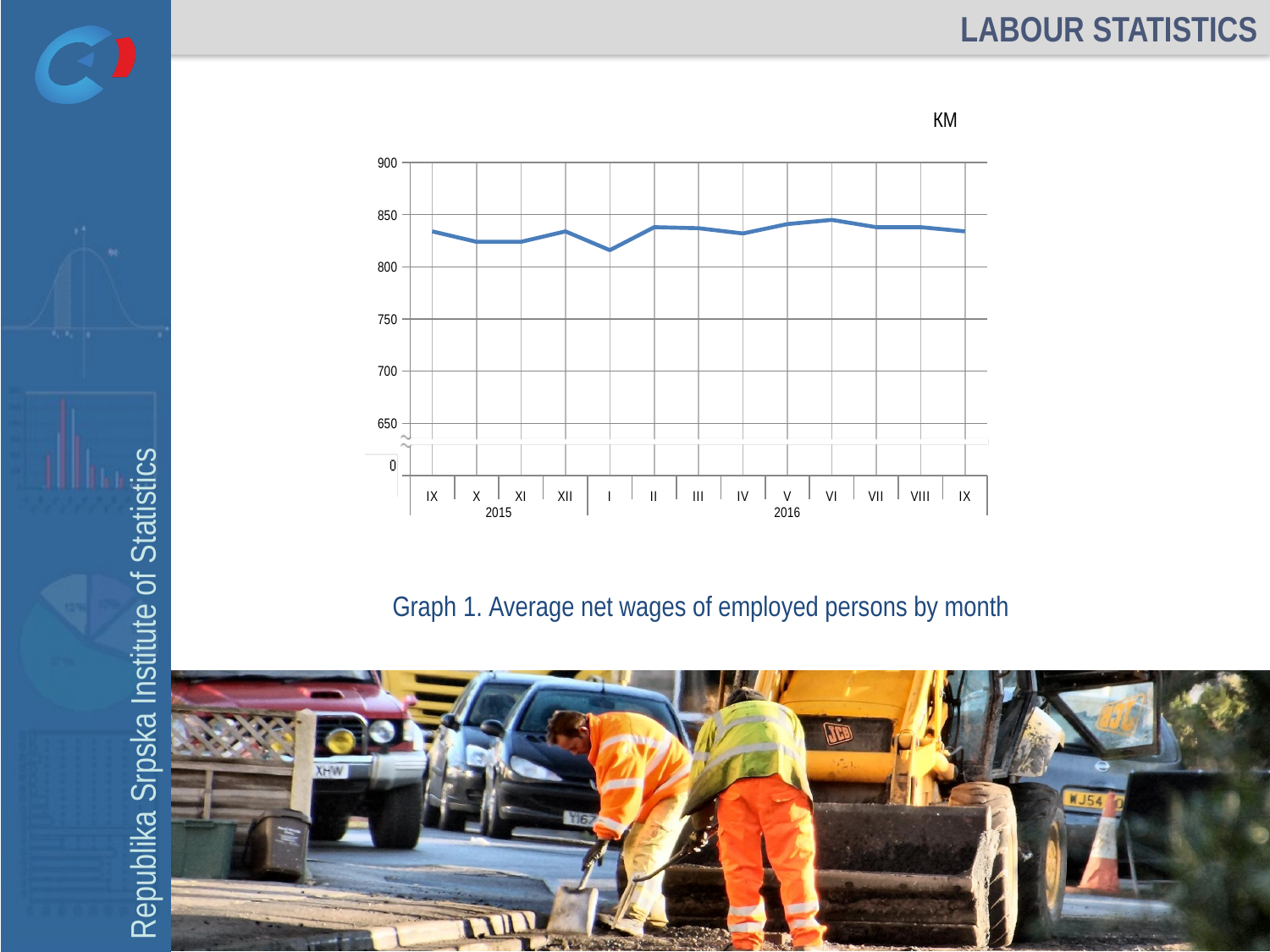
Is the value for IX 2015 greater or less than 800? greater Is the value for I 2016 greater or less than 850? less Which month has the lowest average net wage on the chart? I 2016 What unit is shown above the chart's vertical axis? KM How many monthly data points are plotted on the chart? 13 Which is larger, the value for I 2016 or the value for VI 2016? VI 2016 Is the value for I 2016 greater or less than 800? greater What is the title of the chart on the slide? Graph 1. Average net wages of employed persons by month What kind of chart is shown on the slide? line chart Does the line rise or fall from XII 2015 to I 2016? fall Which is larger, the value for X 2015 or the value for II 2016? II 2016